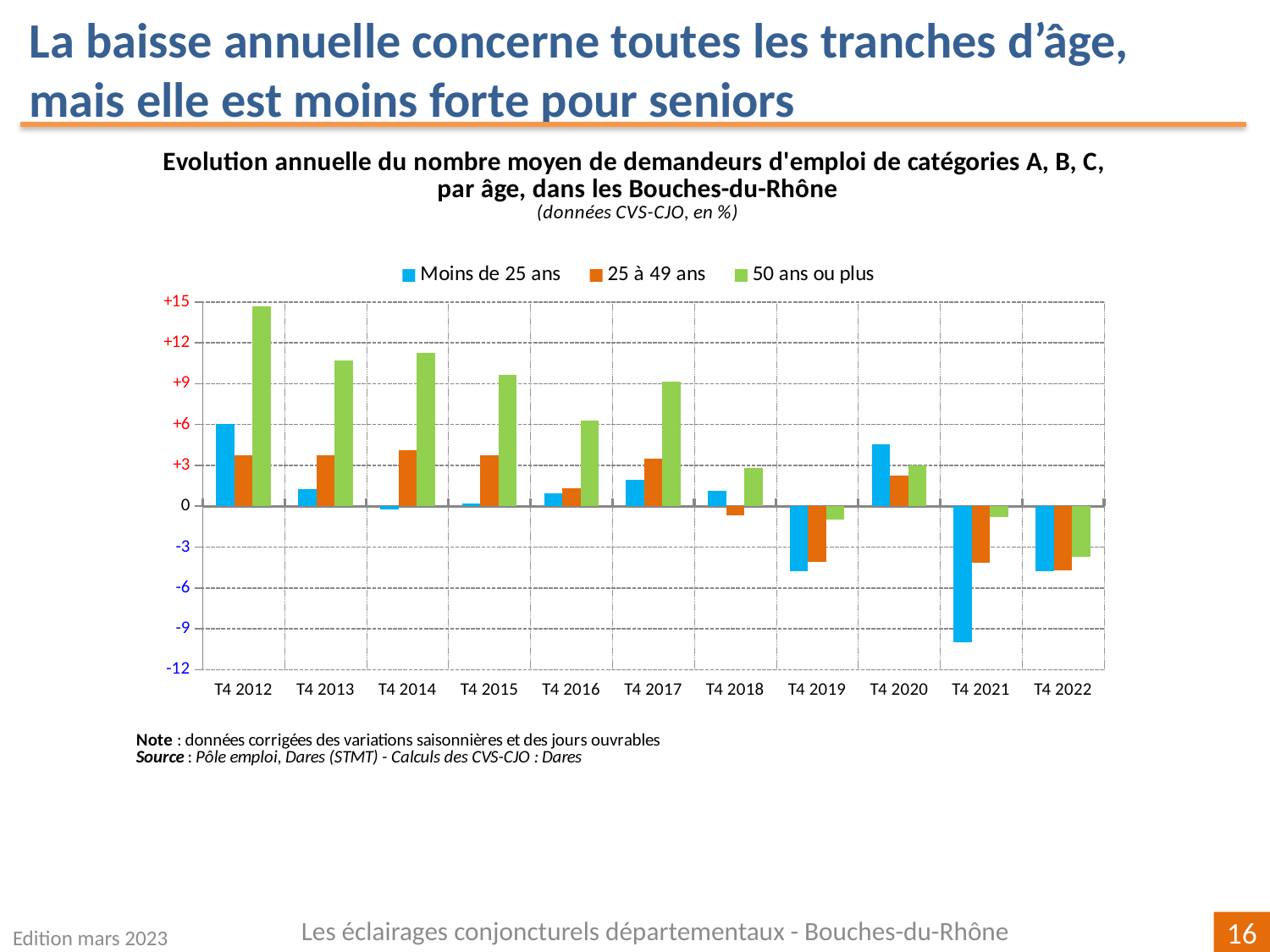
Is the value for '50 ans ou plus' in T4 2016 greater or less than +3? greater In which period is the value for '50 ans ou plus' the highest? T4 2012 In which period is the value for 'Moins de 25 ans' the lowest? T4 2021 Which colour represents the '50 ans ou plus' series in the legend? green How many series does the legend list? 3 In T4 2020, which is larger: 'Moins de 25 ans' or '25 à 49 ans'? Moins de 25 ans Is the value for '50 ans ou plus' in T4 2012 greater or less than +12? greater What kind of chart is shown on the slide? bar chart Is the value for '25 à 49 ans' in T4 2019 greater or less than -3? less In T4 2014, which is larger: '50 ans ou plus' or '25 à 49 ans'? 50 ans ou plus How many periods (T4 years) are shown on the x axis? 11